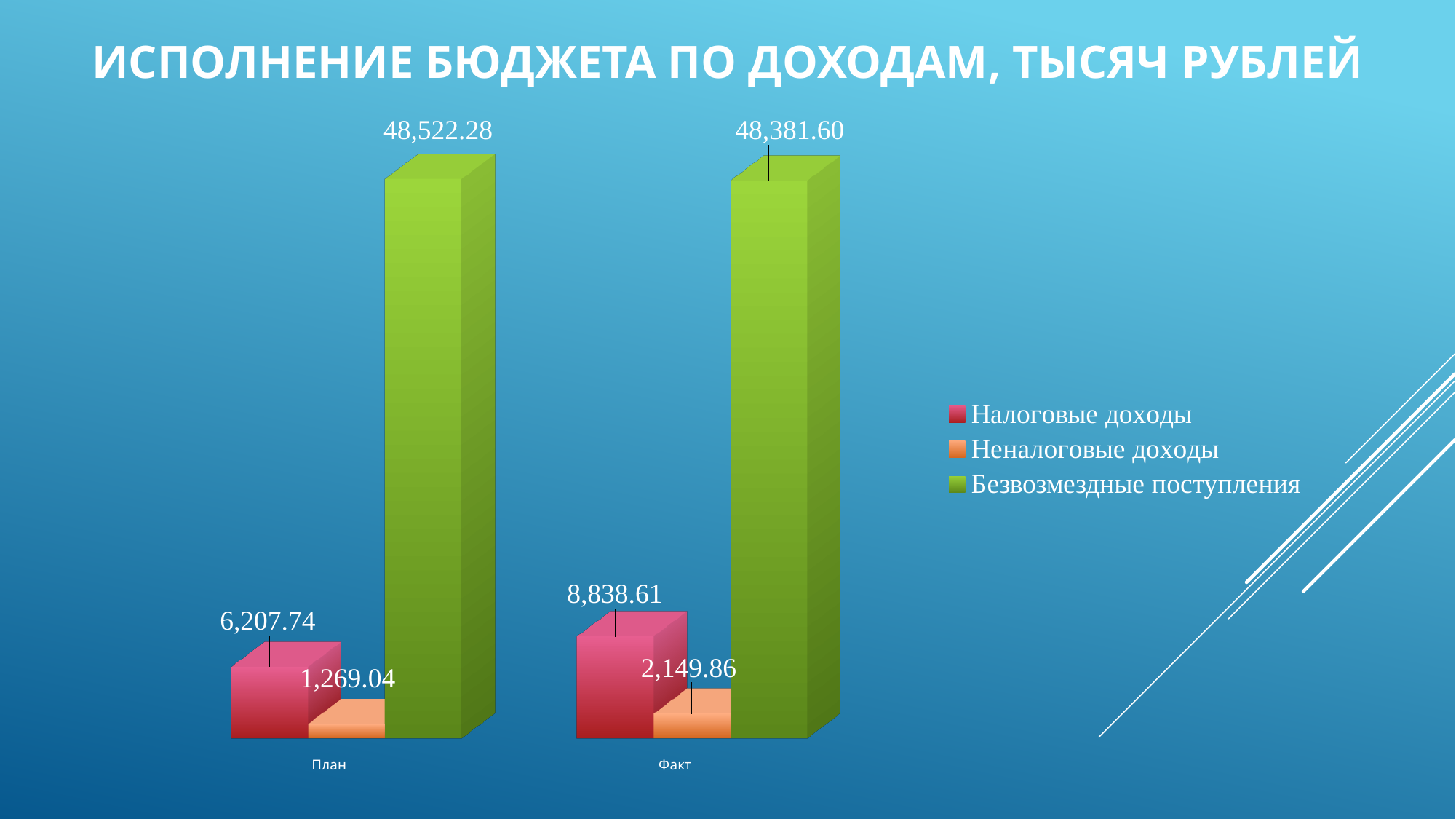
How many categories are shown on the x axis? 2 Which is larger: Безвозмездные поступления for План or for Факт? План What is the difference between Неналоговые доходы for Факт and for План? 880.82 What is the difference between Налоговые доходы for Факт and for План? 2,630.87 How many series does the legend list? 3 What is the value of Неналоговые доходы for Факт? 2,149.86 What type of chart is shown on the slide? Bar chart What is the value of Безвозмездные поступления for План? 48,522.28 What is the value of Налоговые доходы for План? 6,207.74 What is the value of Безвозмездные поступления for Факт? 48,381.60 Which series has the lowest value in the План category? Неналоговые доходы Which series has the highest value in the Факт category? Безвозмездные поступления